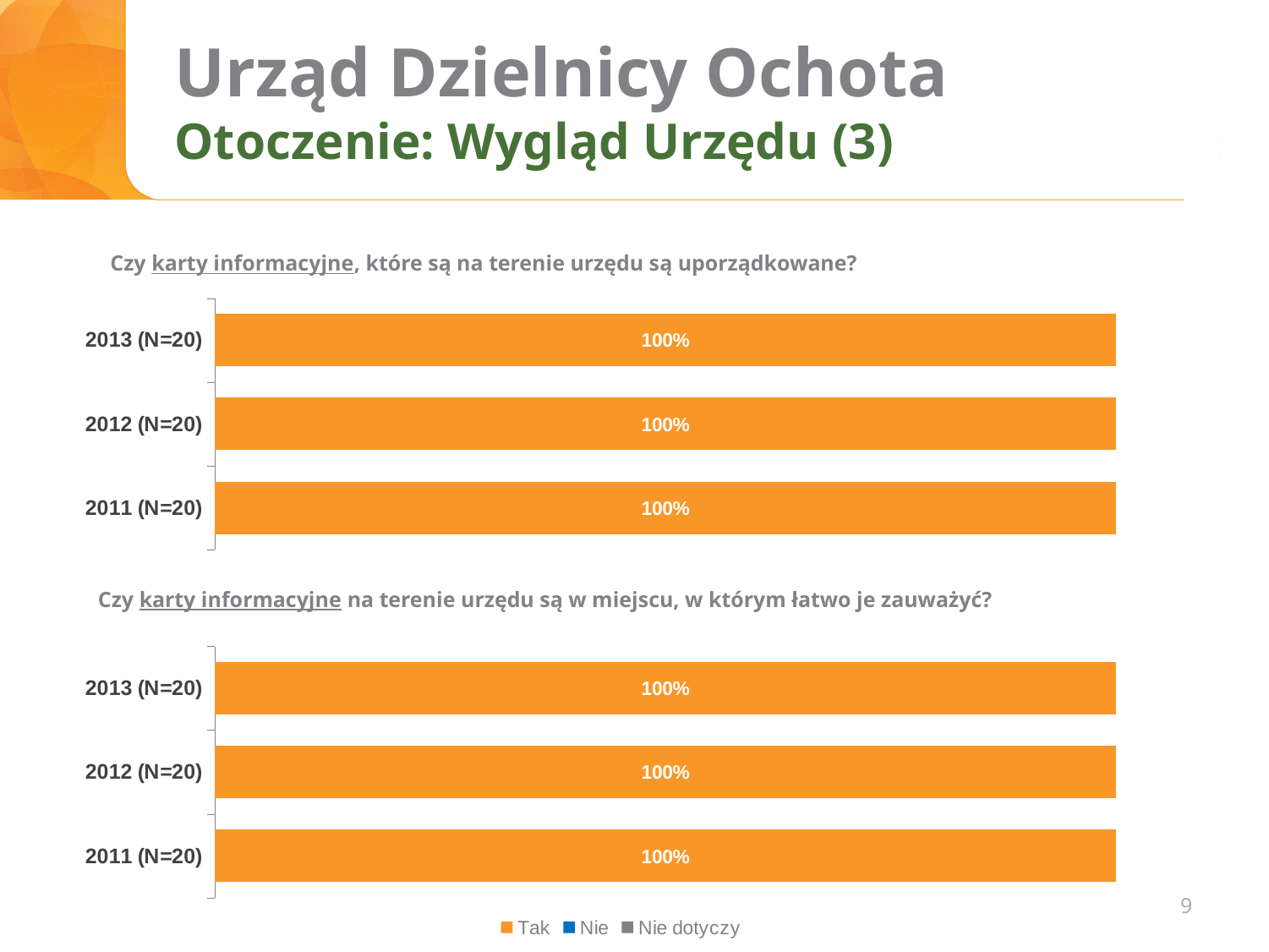
Which series does the orange colour represent in the legend? Tak In the bottom chart, do the values rise, fall or stay the same from 2011 to 2013? Stay the same What is the sample size (N) shown for each year in the top chart? N=20 In the bottom chart ("Czy karty informacyjne na terenie urzędu są w miejscu, w którym łatwo je zauważyć?"), what is the value for 2012 (N=20)? 100% How many categories (years) are shown in the bottom chart? 3 In the top chart ("Czy karty informacyjne, które są na terenie urzędu są uporządkowane?"), what is the value for 2011 (N=20)? 100% In the top chart, what is the difference between the values for 2013 (N=20) and 2011 (N=20)? 0% In the bottom chart ("Czy karty informacyjne na terenie urzędu są w miejscu, w którym łatwo je zauważyć?"), what is the value for 2013 (N=20)? 100% How many categories (years) are shown in the top chart? 3 In the top chart ("Czy karty informacyjne, które są na terenie urzędu są uporządkowane?"), what is the value for 2013 (N=20)? 100% What type of chart is the bottom chart? Bar chart How many series does the legend at the bottom of the slide list? 3